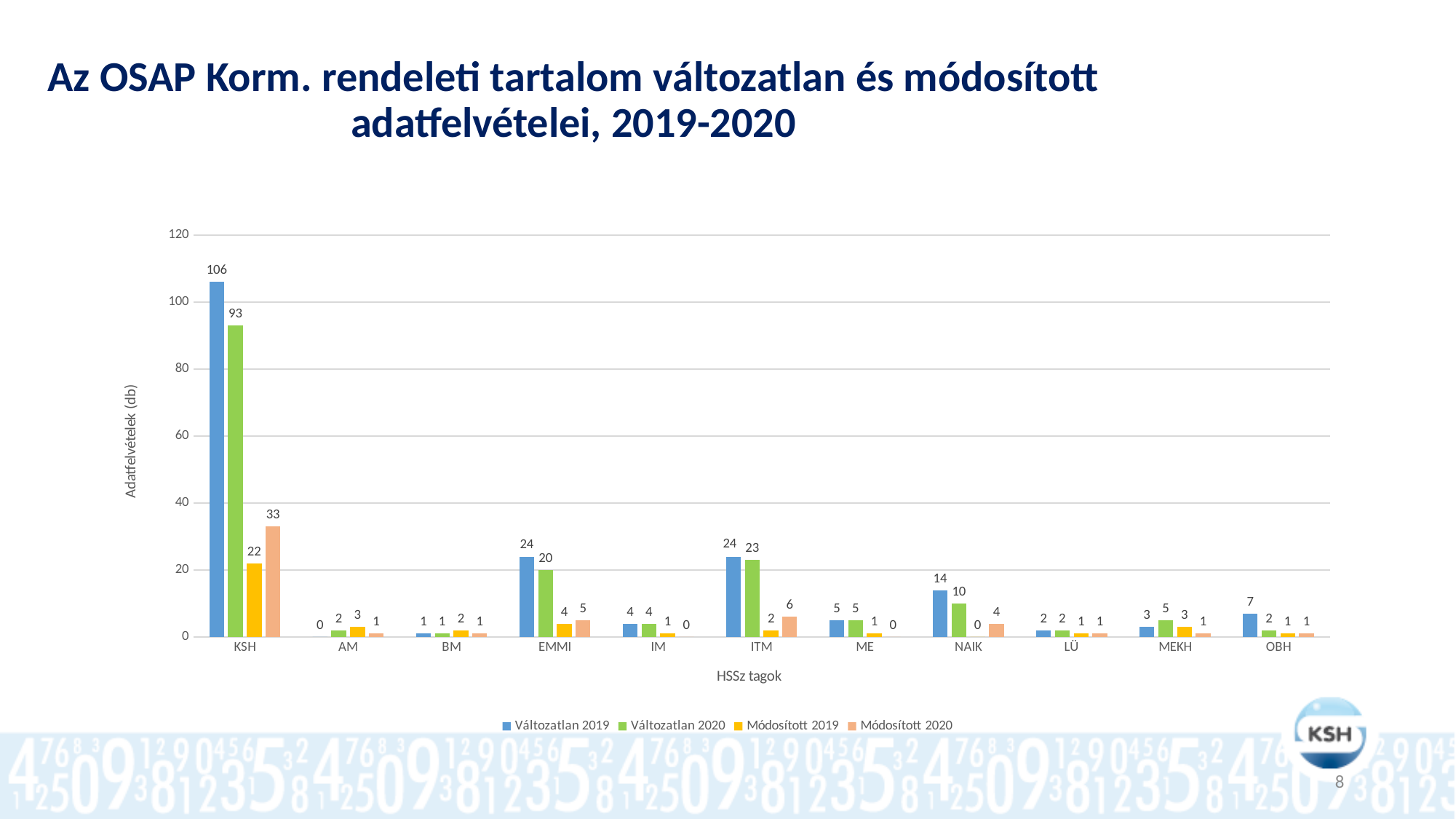
What is the difference between the Változatlan 2019 and Változatlan 2020 values for KSH? 13 What kind of chart is shown on the slide? Bar chart Which is larger for EMMI: Változatlan 2019 or Módosított 2019? Változatlan 2019 What is the value of Változatlan 2020 for NAIK? 10 What is the label of the y axis? Adatfelvételek (db) Which category has the highest Változatlan 2019 value? KSH What is the value of Módosított 2020 for ITM? 6 How many series does the legend list? 4 How many categories are shown on the x axis? 11 What is the label of the x axis? HSSz tagok Which category has the lowest Változatlan 2019 value? AM What is the value of Változatlan 2019 for KSH? 106